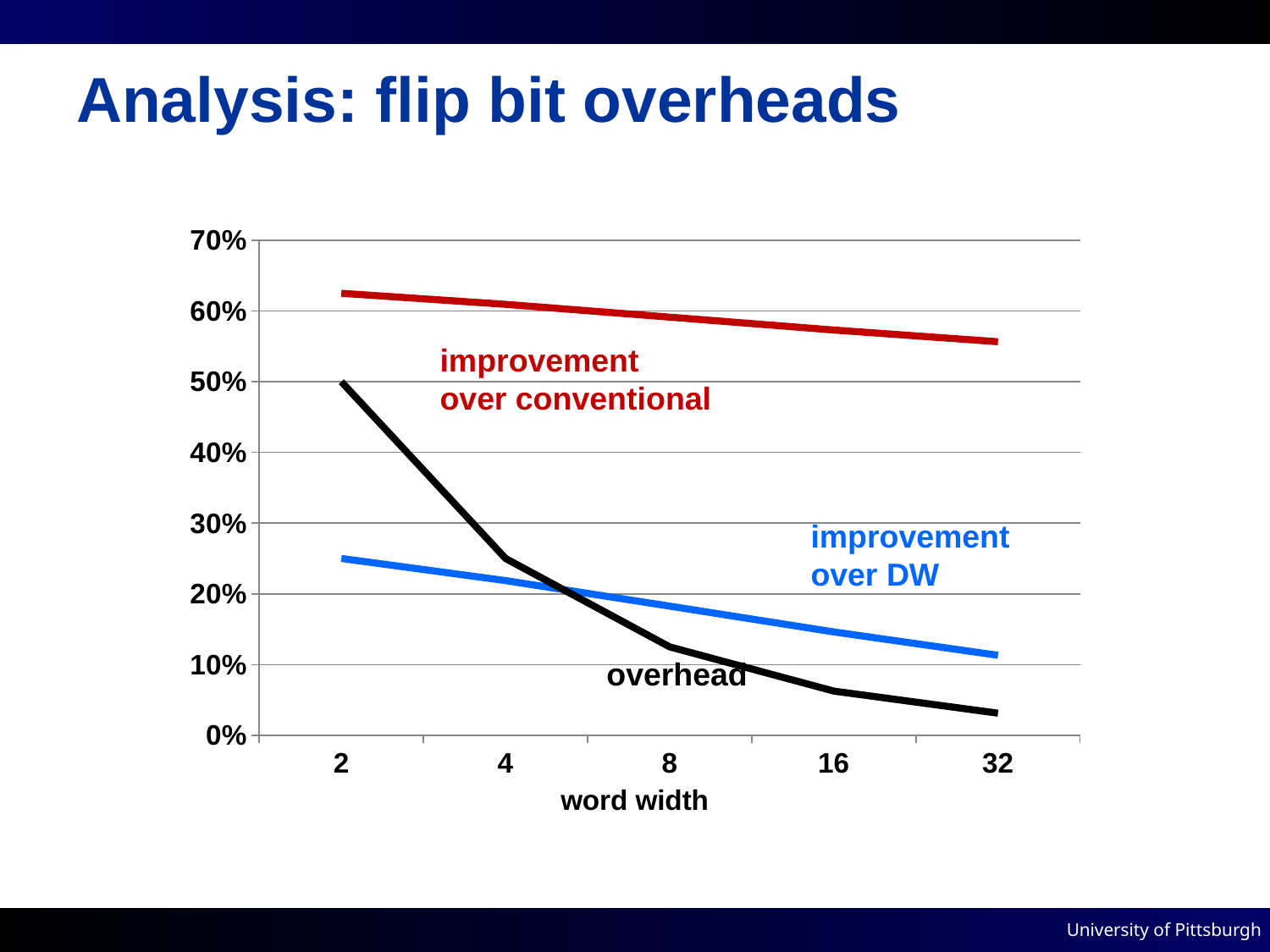
Does the overhead series rise or fall as word width increases? fall What is the label of the x axis? word width Which series has the lowest value at word width 32? overhead How many word width values are plotted along the x axis? 5 Is the improvement over conventional value at word width 2 greater or less than 60%? greater What kind of chart is shown on the slide? line chart Which series has the highest value at word width 2? improvement over conventional Which series is drawn in red? improvement over conventional Does the improvement over conventional series rise or fall as word width increases? fall Is the overhead value at word width 32 greater or less than 10%? less At word width 8, which is larger: improvement over DW or overhead? improvement over DW How many series are plotted on the chart? 3